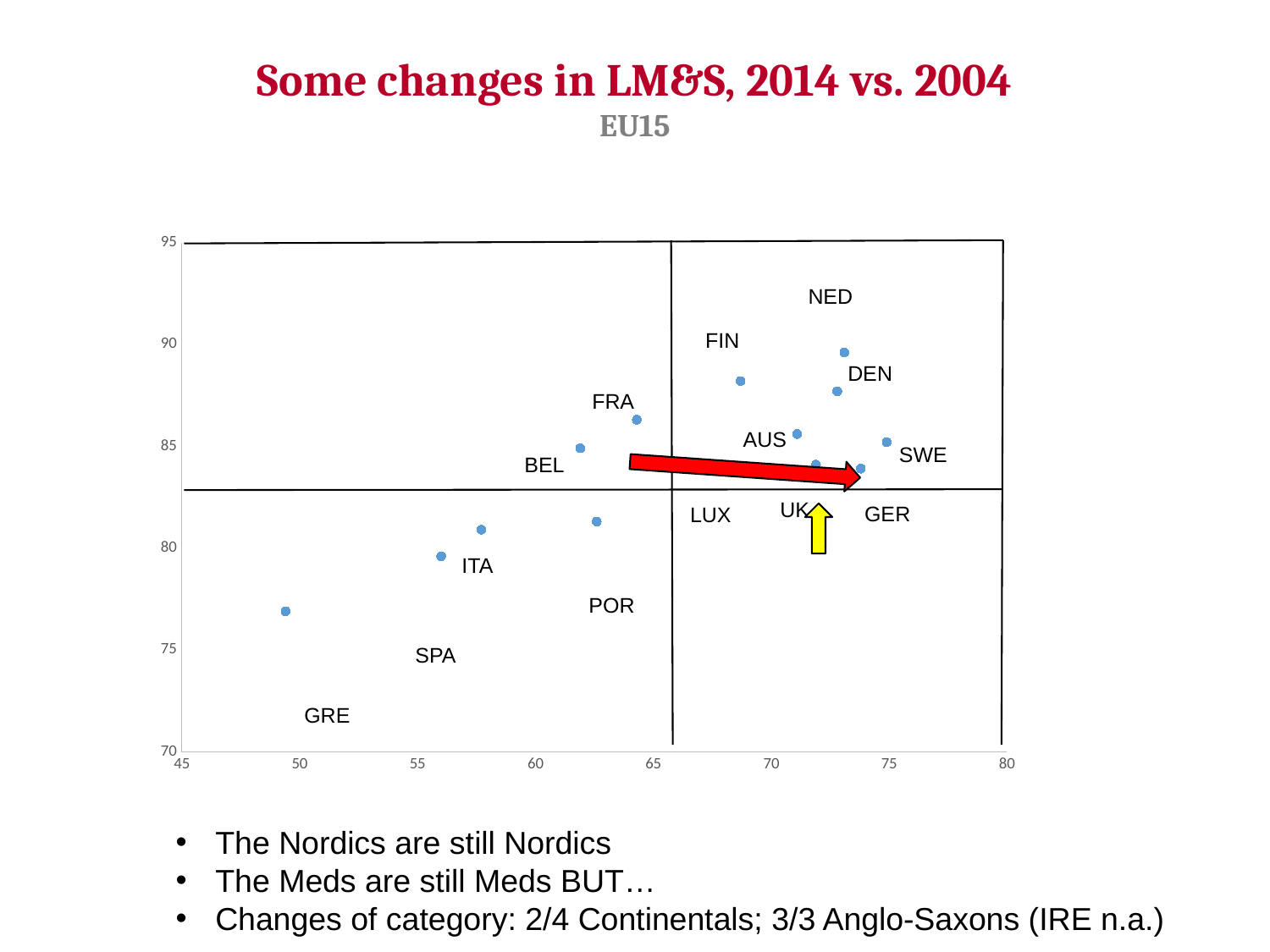
Is the vertical-axis value for NED greater or less than 85? greater Is the vertical-axis value for GRE greater or less than 80? less Which country has the lowest horizontal-axis value in the chart? GRE What is the title of the chart on the slide? Some changes in LM&S, 2014 vs. 2004 Which country has the highest vertical-axis value in the chart? NED What kind of chart is shown on the slide? scatter chart Which has the larger vertical-axis value, GRE or NED? NED Is the vertical-axis value for FRA greater or less than 85? greater Which has the larger horizontal-axis value, GRE or FIN? FIN Which country has the lowest vertical-axis value in the chart? GRE